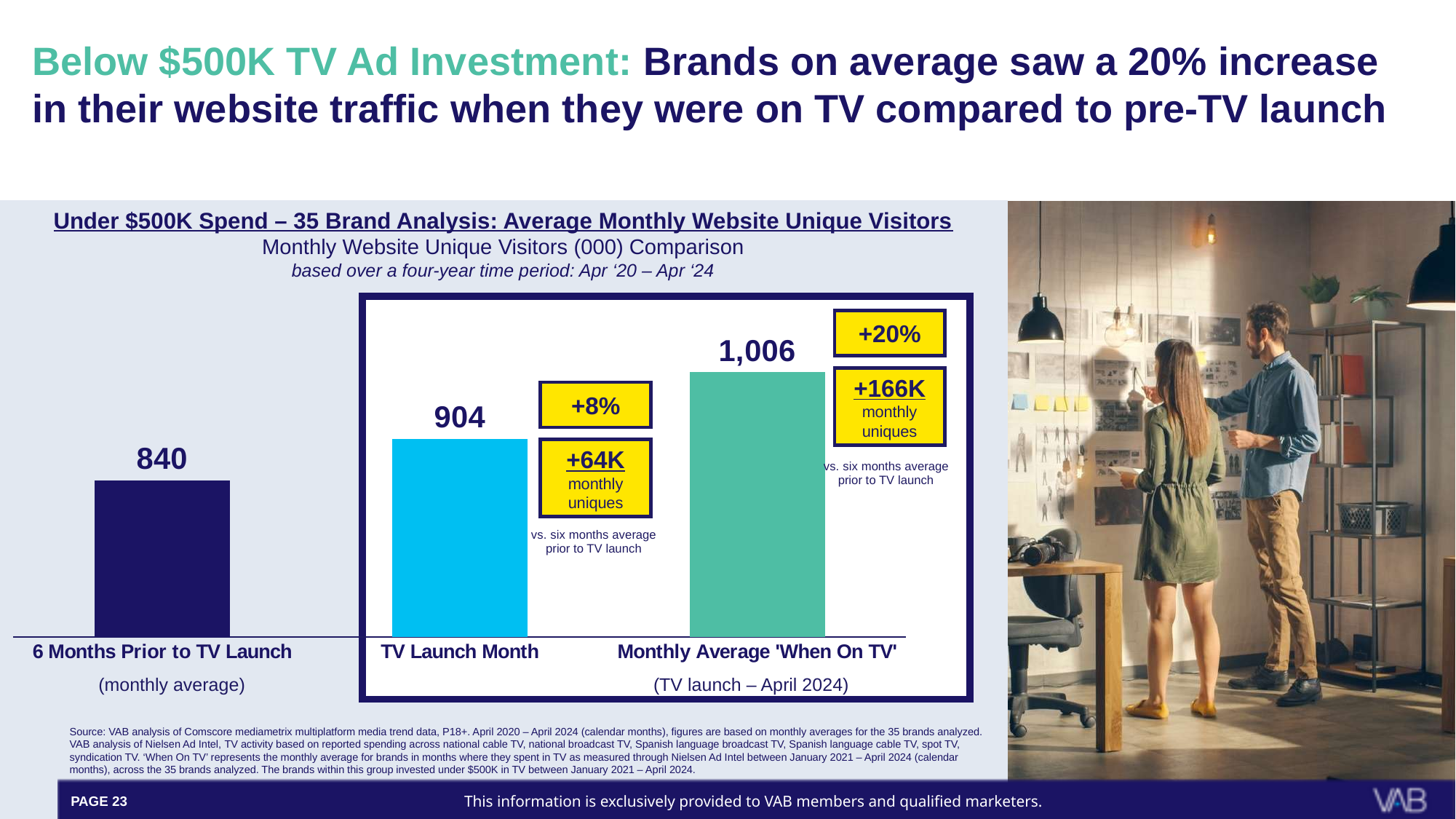
What kind of chart is shown on the slide? Bar chart What is the value for '6 Months Prior to TV Launch'? 840 What is the difference between the 'TV Launch Month' value and the '6 Months Prior to TV Launch' value? 64 What percentage increase is shown for 'Monthly Average 'When On TV'' versus the six months average prior to TV launch? +20% Which category has the highest value? Monthly Average 'When On TV' Which is larger, the value for 'TV Launch Month' or the value for '6 Months Prior to TV Launch'? TV Launch Month What is the difference between the 'Monthly Average 'When On TV'' value and the '6 Months Prior to TV Launch' value? 166 Which category has the lowest value? 6 Months Prior to TV Launch How many bars are shown in the chart? 3 What is the value for 'Monthly Average 'When On TV''? 1,006 What is the value for 'TV Launch Month'? 904 Do the values rise or fall from left to right across the categories? Rise